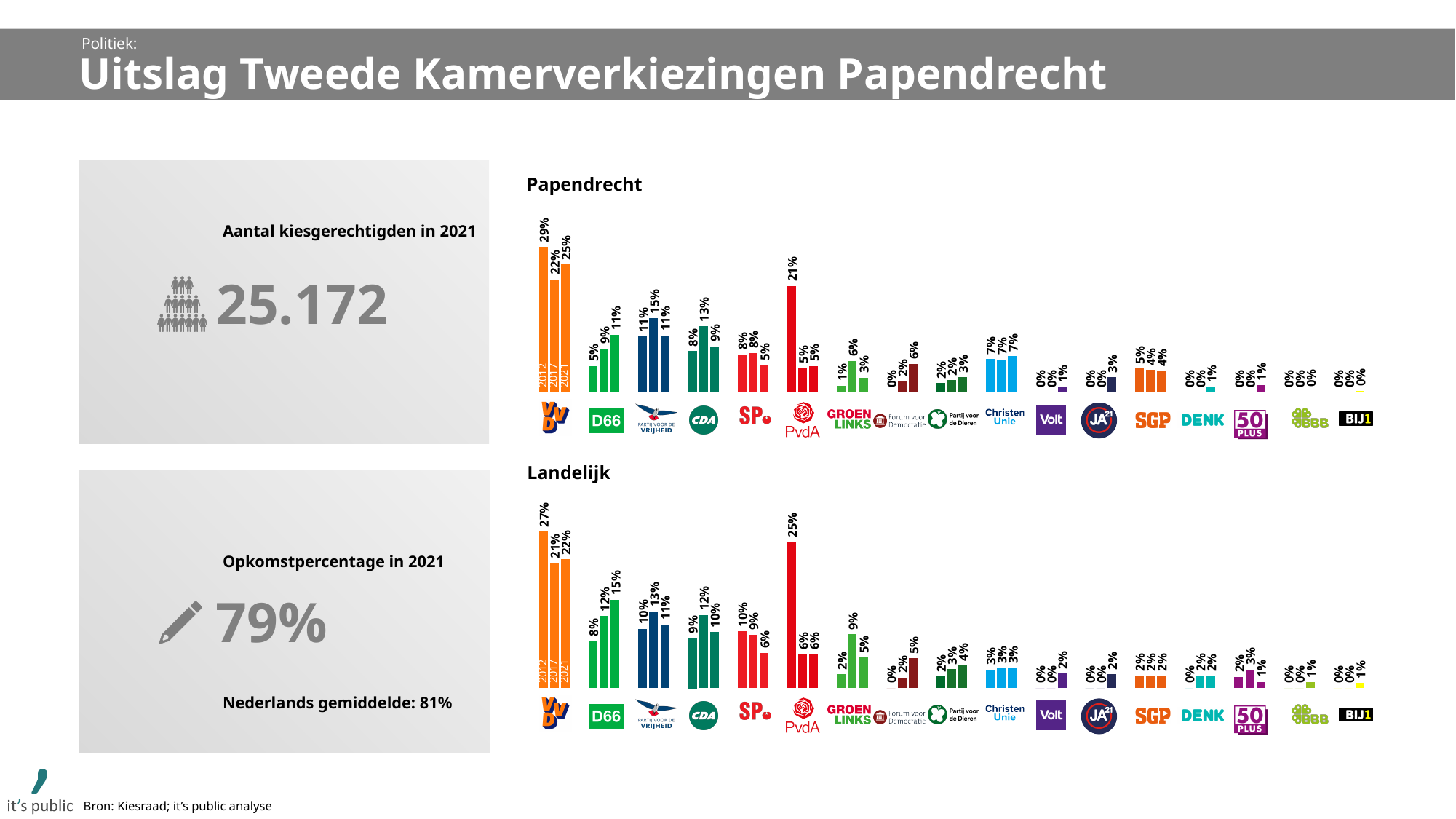
In the Papendrecht chart, what was the VVD's share in 2021? 25% In the Papendrecht chart, which was larger in 2021: the share for D66 or the share for CDA? D66 In the Landelijk chart, which party had the highest share in 2012? VVD What kind of chart is the Landelijk chart? Bar chart In the Landelijk chart, what is the difference between the PvdA's 2012 share and its 2017 share? 19% In the Papendrecht chart, what is the difference between the VVD's 2012 share and its 2017 share? 7% In the Landelijk chart, what was D66's share in 2021? 15% In the Papendrecht chart, what was the PvdA's share in 2012? 21% In the Papendrecht chart, did the share for D66 rise or fall from 2012 to 2021? Rise In the Papendrecht chart, which party had the highest share in 2021? VVD In the Landelijk chart, which was larger in 2021: the share for PVV or the share for SP? PVV How many parties are shown in the Papendrecht chart? 17